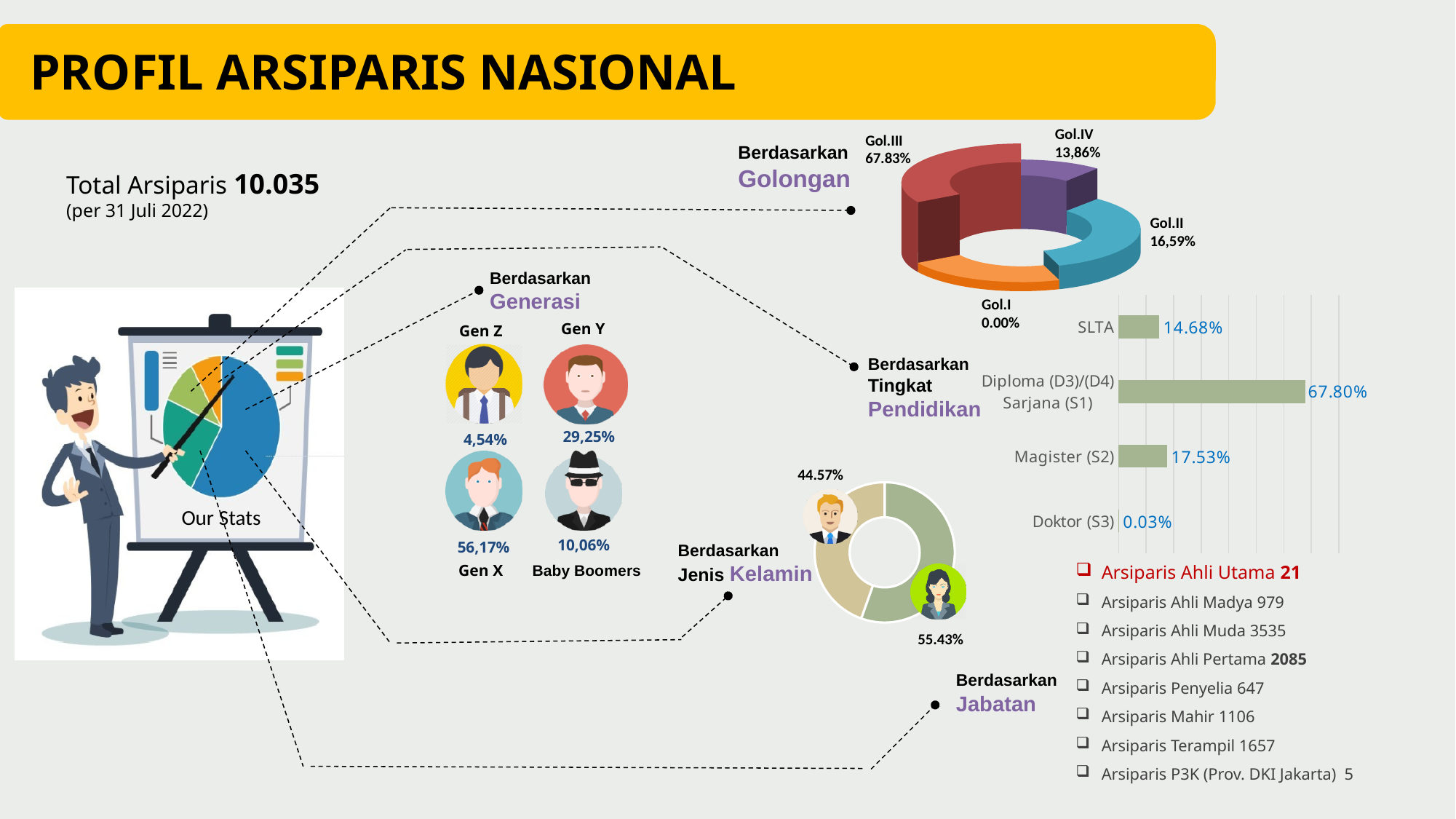
In the Berdasarkan Tingkat Pendidikan chart, what is the value for Magister (S2)? 17.53% In the Berdasarkan Golongan chart, what percentage is shown for Gol.II? 16,59% How many categories does the Berdasarkan Golongan chart show? 4 What kind of chart is the Berdasarkan Golongan chart? Donut chart In the Berdasarkan Golongan chart, which category has the smallest share? Gol.I In the Berdasarkan Tingkat Pendidikan chart, what is the difference between Magister (S2) and SLTA? 2.85% In the Berdasarkan Tingkat Pendidikan chart, which category has the highest value? Diploma (D3)/(D4) Sarjana (S1) What kind of chart is the Berdasarkan Tingkat Pendidikan chart? Bar chart In the Berdasarkan Tingkat Pendidikan chart, what is the value for SLTA? 14.68% In the Berdasarkan Golongan chart, what percentage is shown for Gol.III? 67.83% In the Berdasarkan Jenis Kelamin chart, what is the larger of the two percentages shown? 55.43% In the Berdasarkan Golongan chart, which category has the largest share? Gol.III